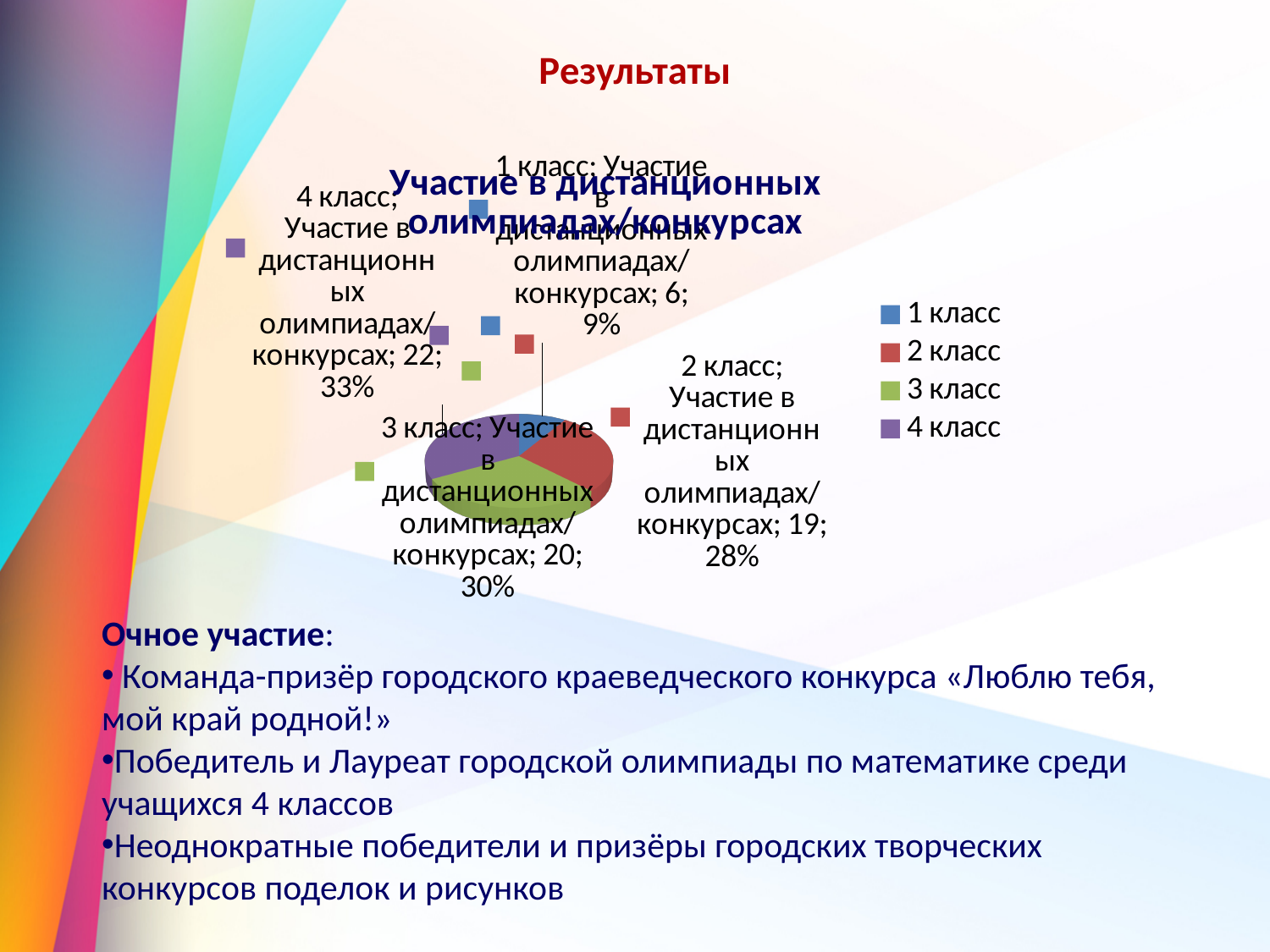
What is the title of the pie chart? Участие в дистанционных олимпиадах/конкурсах Which class has the largest slice in the pie chart? 4 класс What is the value for 3 класс in the pie chart? 20 How many entries does the legend list? 4 What is the value for 2 класс in the pie chart? 19 What is the value for 4 класс in the pie chart? 22 What is the value for 1 класс in the pie chart? 6 Which class has the smallest slice in the pie chart? 1 класс What is the difference between the values for 4 класс and 1 класс? 16 What share of the pie does 4 класс represent? 33% What kind of chart is shown on the slide? Pie chart What share of the pie does 1 класс represent? 9%